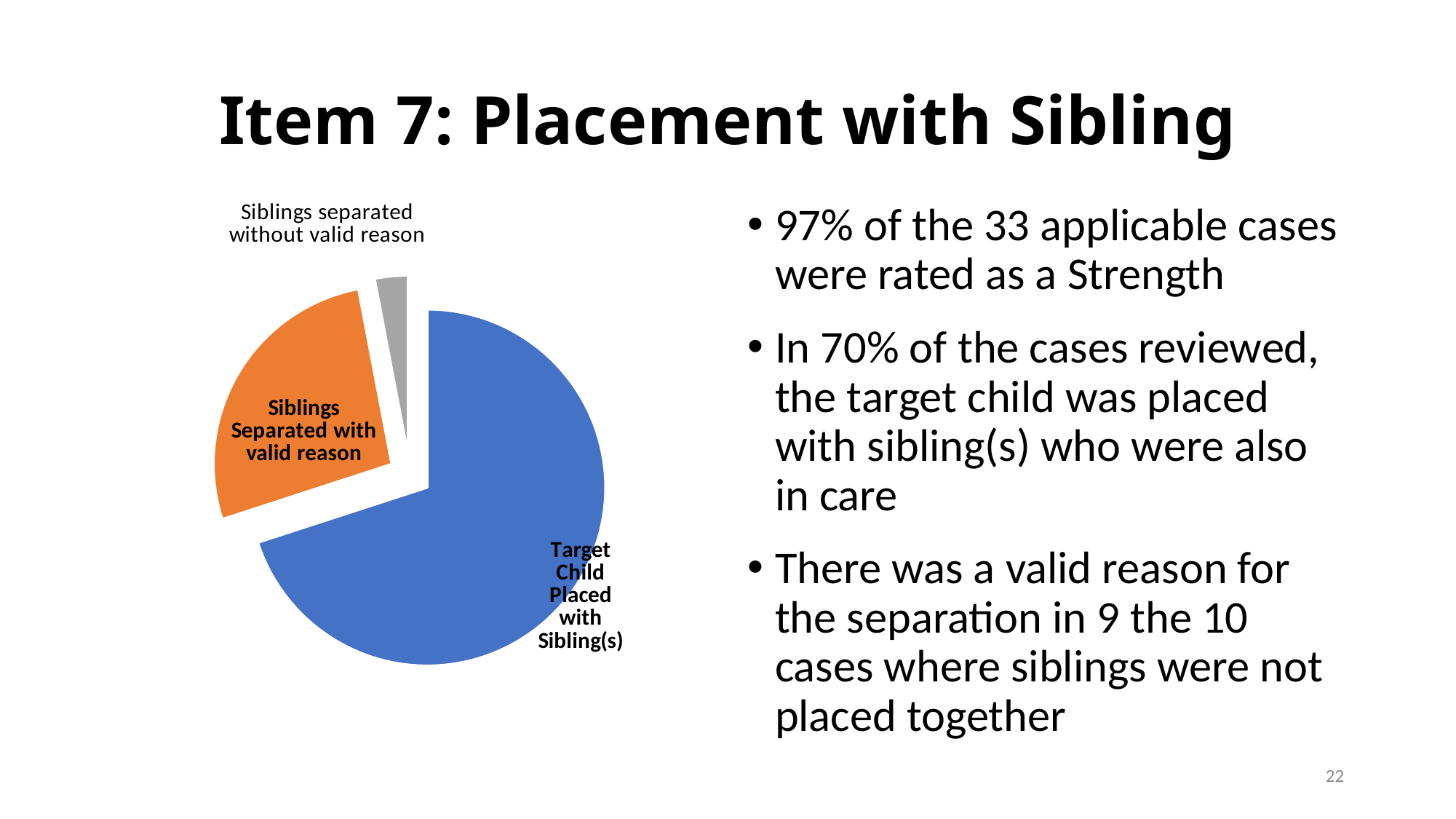
What kind of chart is shown on the slide? Pie chart What colour is the slice for Target Child Placed with Sibling(s)? Blue How many slices does the pie chart have? 3 Which category has the largest slice of the pie chart? Target Child Placed with Sibling(s) What colour is the slice for Siblings Separated with valid reason? Orange Which slice is larger: Target Child Placed with Sibling(s) or Siblings Separated with valid reason? Target Child Placed with Sibling(s) Which category has the smallest slice of the pie chart? Siblings separated without valid reason Which slice is larger: Siblings Separated with valid reason or Siblings separated without valid reason? Siblings Separated with valid reason